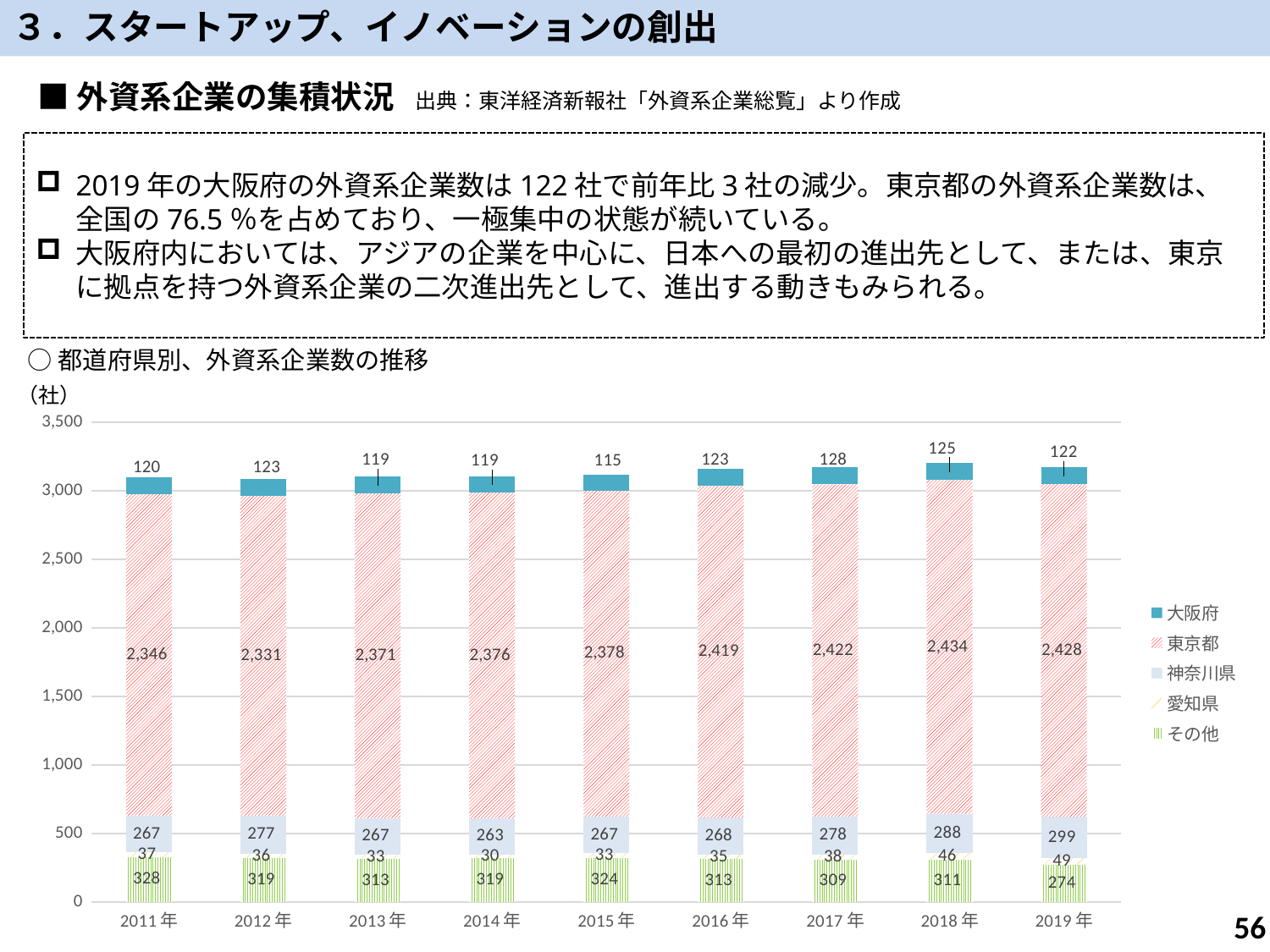
In which year is the value for 大阪府 lowest? 2015年 What is the value for その他 in 2019年? 274 Which is larger, the 東京都 value in 2018年 or in 2019年? 2018年 How many years are shown on the x axis? 9 What is the total of the stacked bar for 2019年? 3,172 What is the value for 神奈川県 in 2018年? 288 In which year is the value for 大阪府 highest? 2017年 What kind of chart is shown? Stacked bar chart What is the value for 大阪府 in 2019年? 122 How many series does the legend list? 5 What is the difference between the 大阪府 value in 2018年 and in 2019年? 3 What is the value for 東京都 in 2011年? 2,346